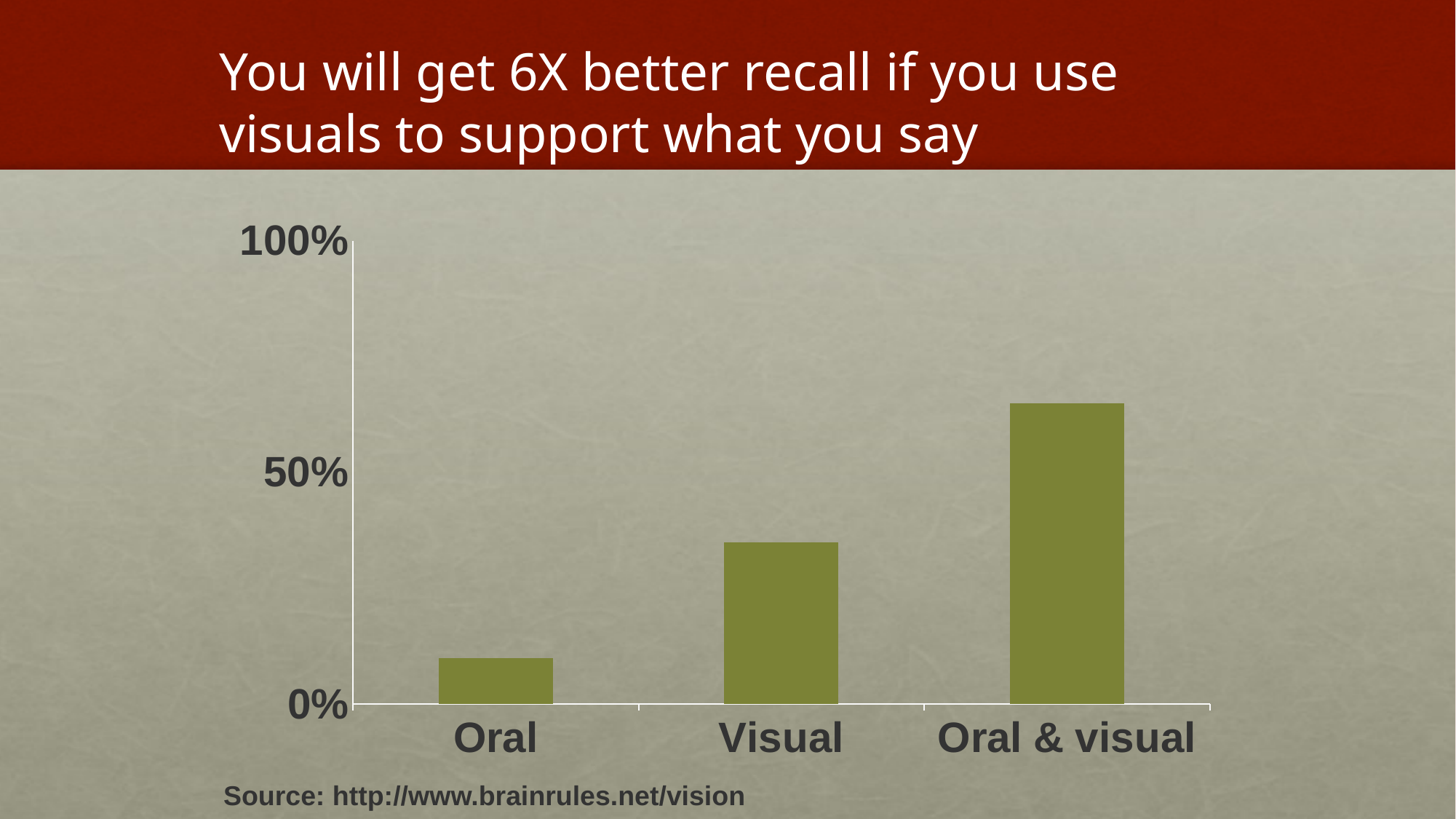
Is the value for Oral & visual greater or less than 50%? greater Which category has the lowest bar in the chart? Oral Which is larger, the value for Oral & visual or the value for Visual? Oral & visual What is the highest value labelled on the vertical axis of the chart? 100% How many categories are shown on the x axis of the chart? 3 Which is larger, the value for Visual or the value for Oral? Visual Is the value for Visual greater or less than 50%? less Is the value for Oral greater or less than 50%? less Which category has the highest bar in the chart? Oral & visual What source is cited below the chart? http://www.brainrules.net/vision Do the bar values rise or fall from left to right across the x axis? rise What kind of chart is shown on the slide? bar chart